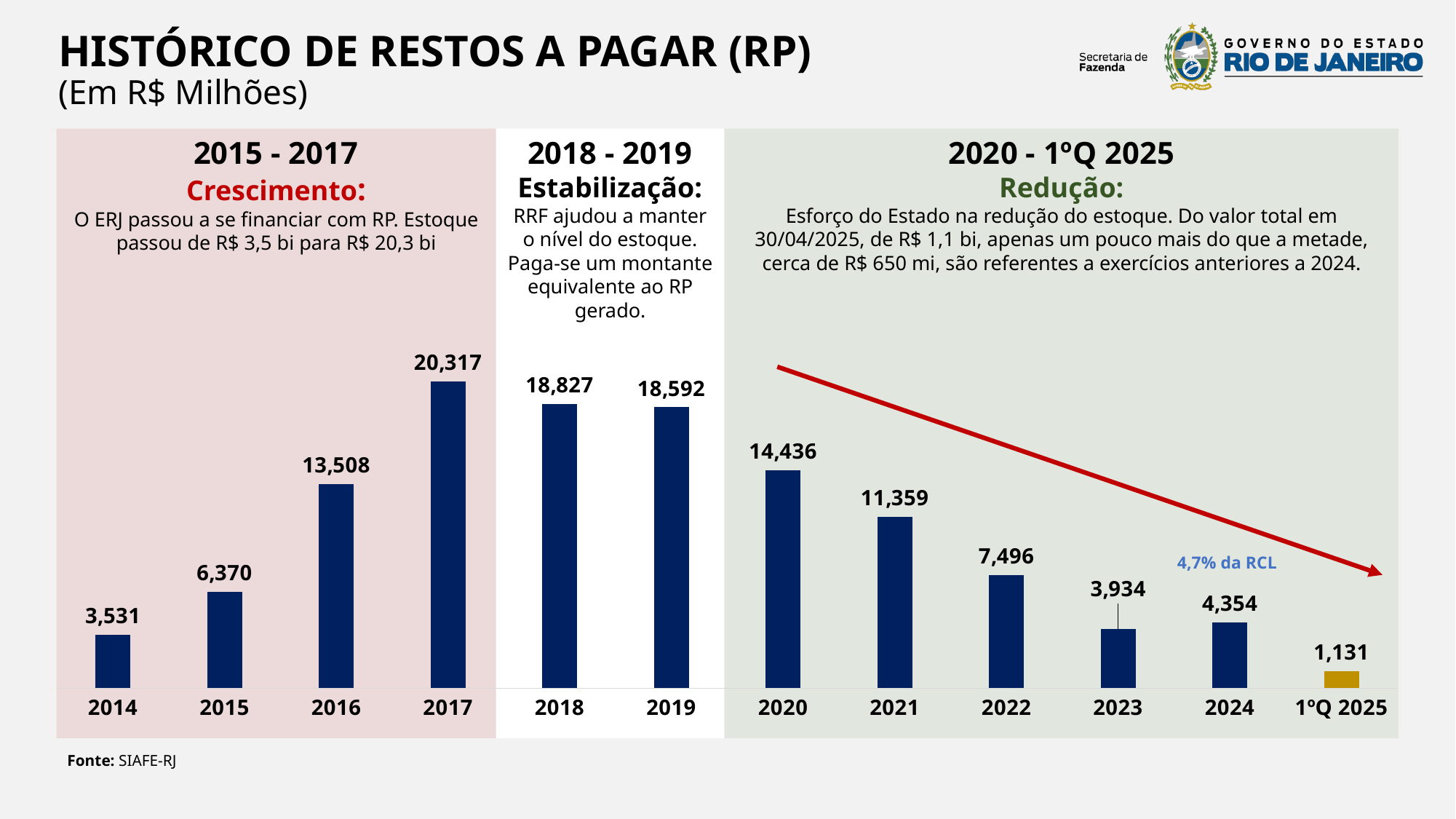
What kind of chart is shown on the slide? Bar chart What is the title of the chart? HISTÓRICO DE RESTOS A PAGAR (RP) What is the value for 1ºQ 2025? 1,131 What is the difference between the values for 2018 and 2019? 235 What is the value for 2017? 20,317 How many bars are shown in the chart? 12 Which is larger, the value for 2023 or the value for 2024? 2024 Which year has the highest value? 2017 Do the values rise or fall from 2014 to 2017? Rise Which category has the lowest value? 1ºQ 2025 What is the value for 2020? 14,436 What is the difference between the values for 2017 and 2016? 6,809